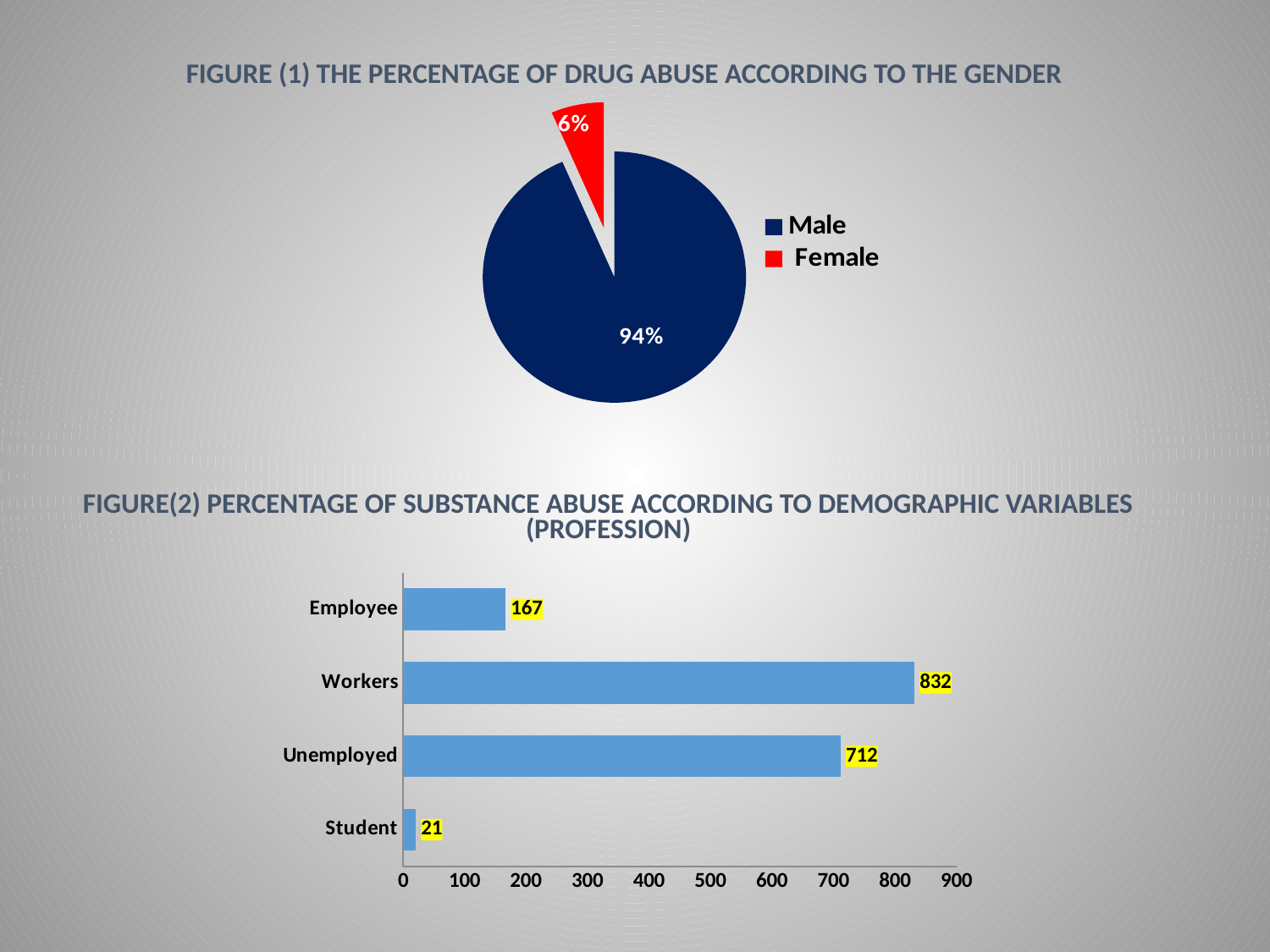
In Figure (2), what is the value for Workers? 832 In Figure (2), which profession has the highest value? Workers In Figure (2), which profession has the lowest value? Student What kind of chart is Figure (1)? Pie chart In Figure (2), what is the value for Student? 21 In Figure (1), what percentage of drug abuse is attributed to females? 6% In Figure (2), what is the difference between the values for Workers and Unemployed? 120 How many categories are shown in Figure (2)? 4 In Figure (2), which is larger, the value for Employee or the value for Unemployed? Unemployed In Figure (1), what percentage of drug abuse is attributed to males? 94% How many entries does the legend of Figure (1) list? 2 In Figure (1), which colour represents Female? Red